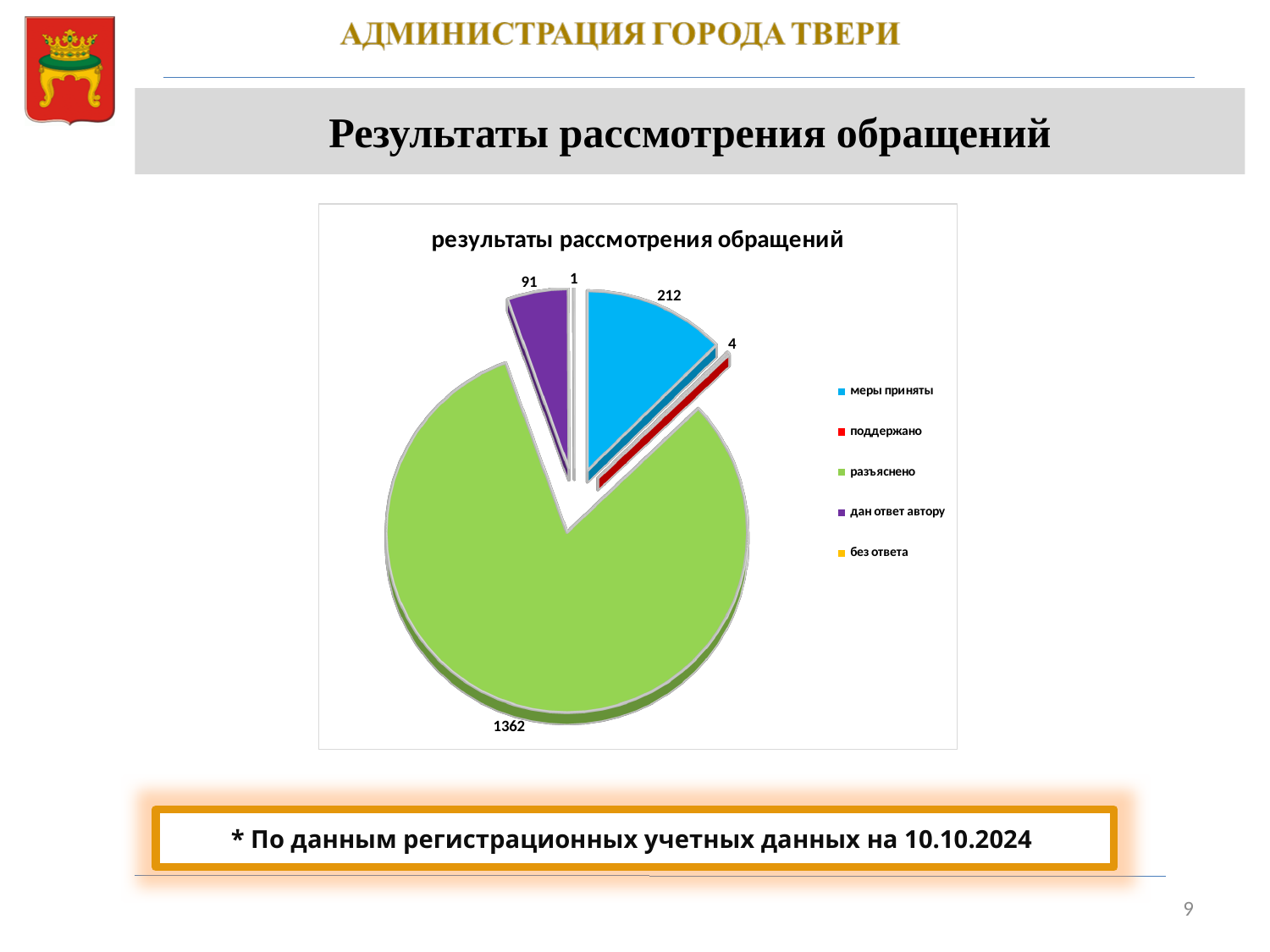
What is the value for "меры приняты"? 212 What is the value for "разъяснено"? 1362 What is the title of the chart? результаты рассмотрения обращений What is the value for "дан ответ автору"? 91 Which category has the smallest value? без ответа What is the value for "без ответа"? 1 What kind of chart is shown on the slide? pie chart What is the difference between the values for "меры приняты" and "дан ответ автору"? 121 Which is larger: "меры приняты" or "дан ответ автору"? меры приняты Which category has the largest slice of the pie? разъяснено How many categories does the legend list? 5 What is the value for "поддержано"? 4